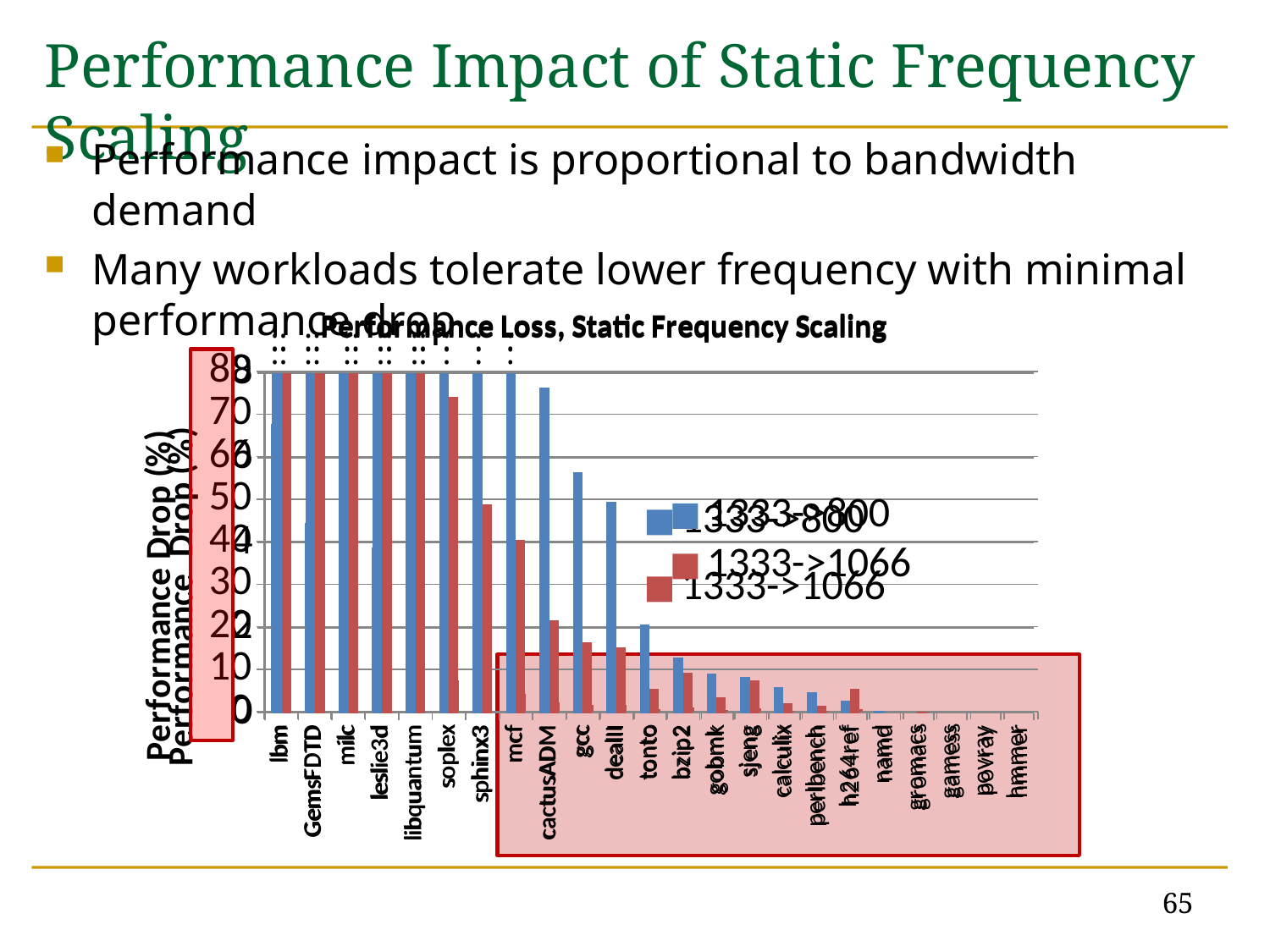
What is the title of the chart? Performance Loss, Static Frequency Scaling Which series is drawn in red in the chart? 1333->1066 How many series does the chart legend list? 2 How many workloads (categories) are plotted along the x axis? 23 Do the performance drop values generally rise or fall moving from left to right along the x axis? fall Which has the larger 1333->1066 performance drop, soplex or sphinx3? soplex What kind of chart is shown on the slide? bar chart Is the 1333->1066 performance drop for tonto greater or less than 10? less